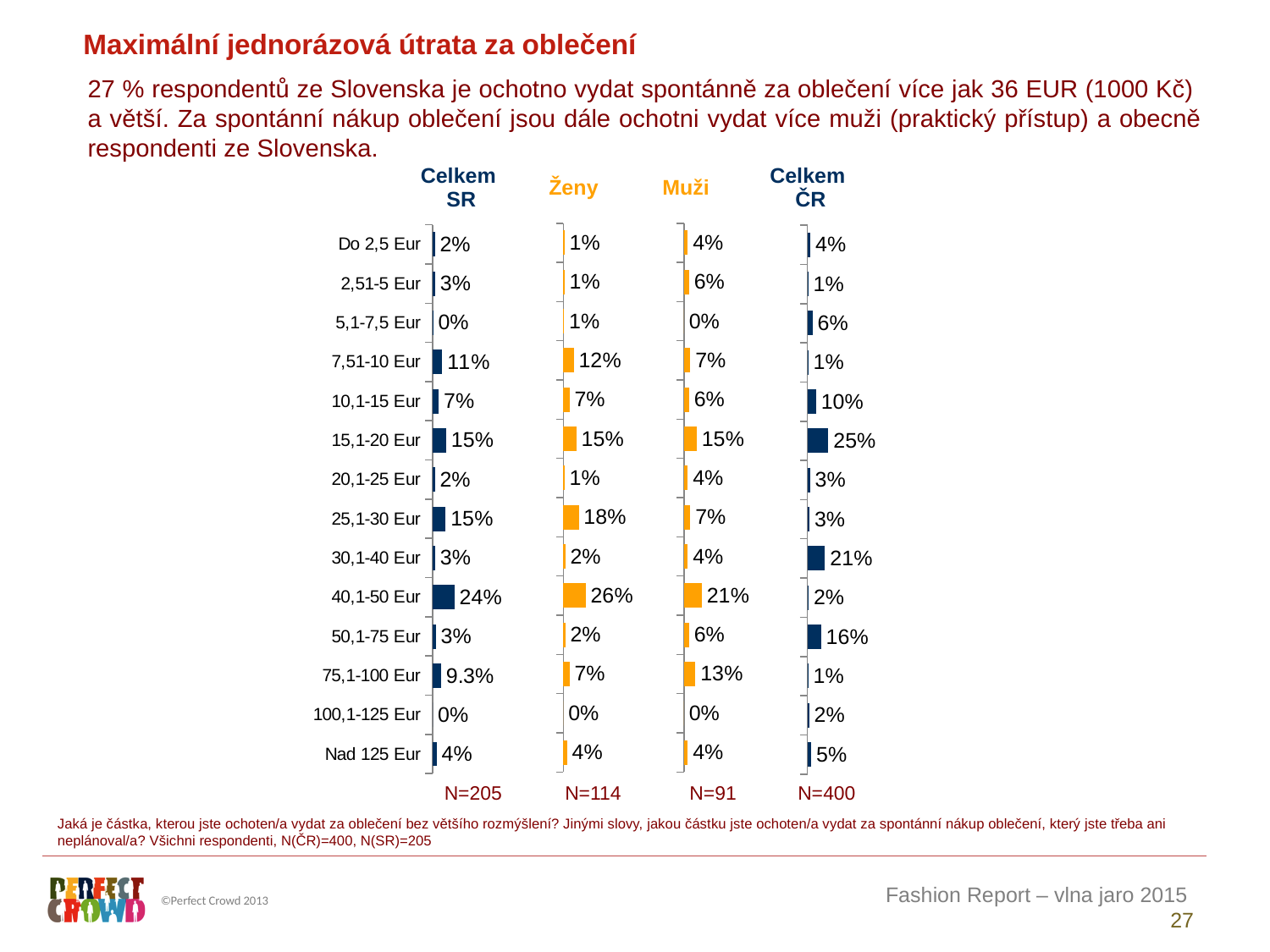
In the Ženy chart, which category has the highest value? 40,1-50 Eur In the Celkem ČR chart, what is the difference between the values for 15,1-20 Eur and 30,1-40 Eur? 4% In the Celkem ČR chart, which category has the highest value? 15,1-20 Eur In the Celkem SR chart, what is the value for 40,1-50 Eur? 24% In the Ženy chart, what is the value for 25,1-30 Eur? 18% What kind of chart is the Celkem ČR chart? bar chart In the Celkem ČR chart, what is the value for 50,1-75 Eur? 16% What is the sample size (N) shown under the Muži chart? N=91 In the Muži chart, what is the value for 75,1-100 Eur? 13% In the Celkem SR chart, what is the value for 75,1-100 Eur? 9.3% How many categories are shown in the Celkem SR chart? 14 In the Muži chart, which is larger: the value for 40,1-50 Eur or the value for 15,1-20 Eur? 40,1-50 Eur